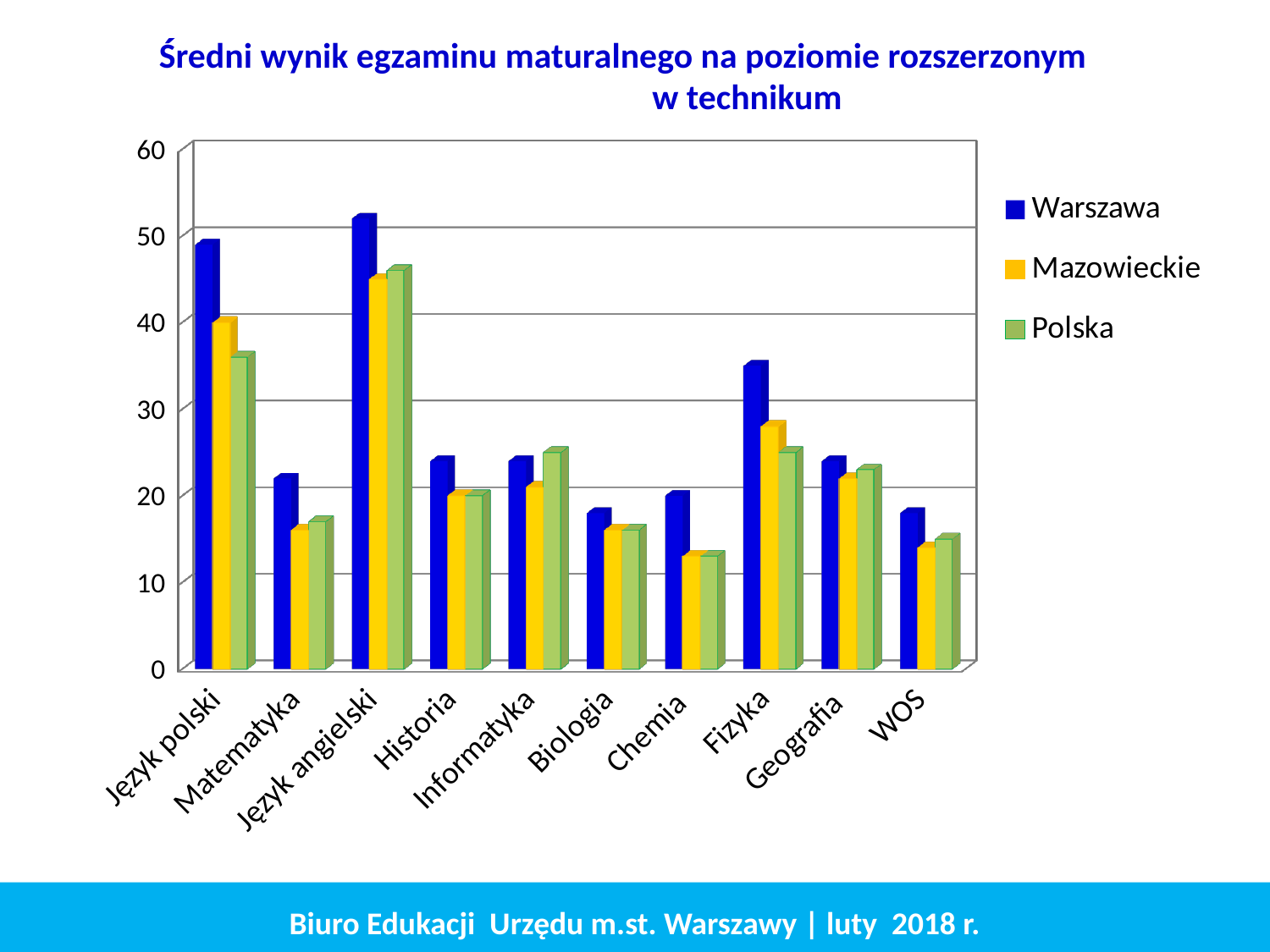
For Język polski, which is larger: the Mazowieckie value or the Polska value? Mazowieckie What kind of chart is shown on the slide? bar chart Is the Mazowieckie value for Chemia greater or less than 20? less How many series does the legend list? 3 Which colour represents the Polska series in the legend? green For Fizyka, which is larger: the Warszawa value or the Mazowieckie value? Warszawa Is the Warszawa value for Język polski greater or less than 40? greater For the Polska series, which subject has the highest value? Język angielski For the Warszawa series, which subject has the highest value? Język angielski Is the Warszawa value for Fizyka greater or less than 40? less How many subjects (categories) are shown on the x axis? 10